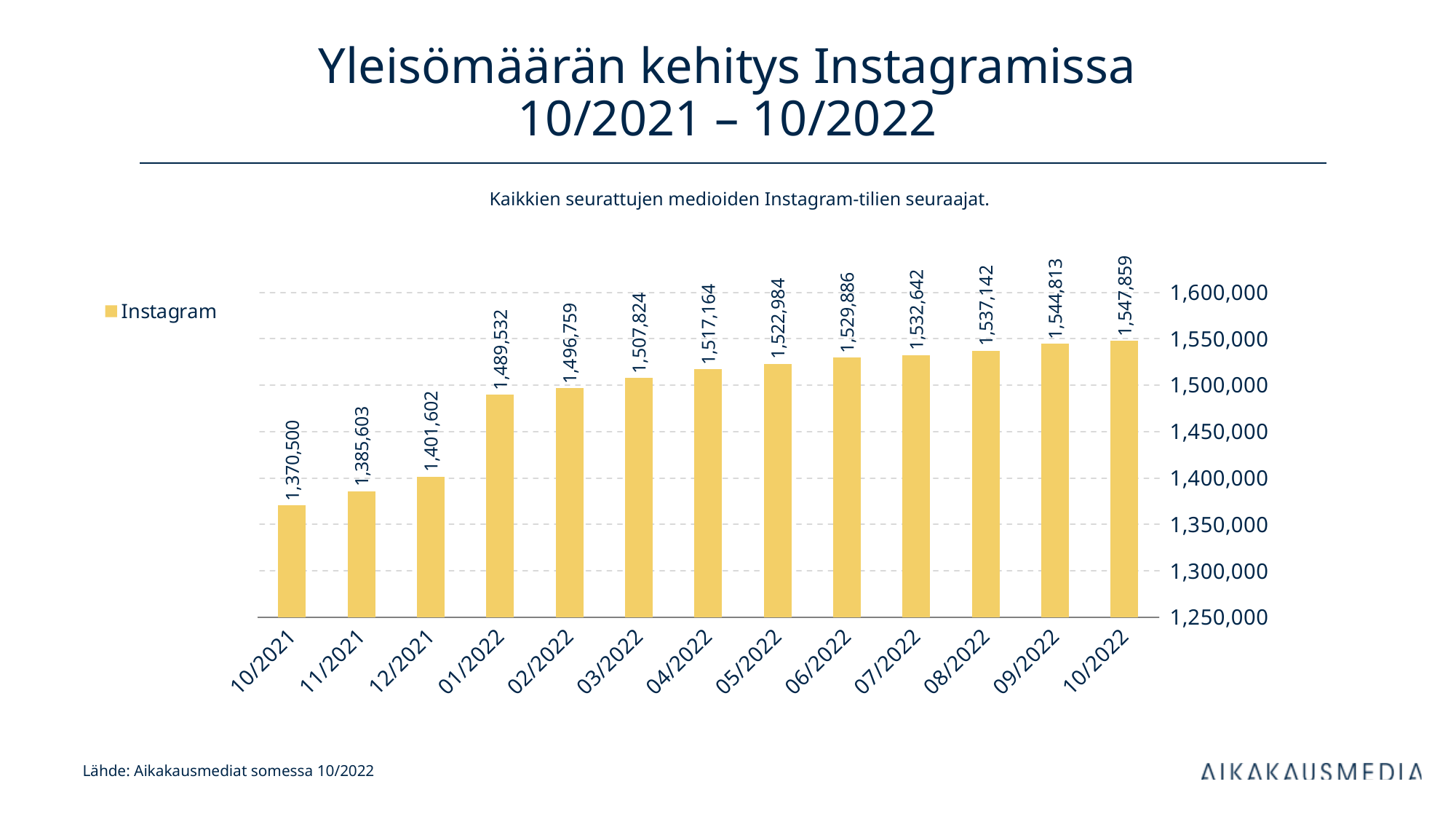
What is the value for 01/2022? 1,489,532 What is the difference between the values for 10/2022 and 10/2021? 177,359 Which is larger, the value for 12/2021 or the value for 03/2022? 03/2022 What is the value for 10/2021? 1,370,500 How many months are shown on the x axis? 13 Which month has the highest value? 10/2022 What is the value for 10/2022? 1,547,859 Is the value for 11/2021 greater or less than 1,400,000? less Which month has the lowest value? 10/2021 Do the values rise or fall from 10/2021 to 10/2022? rise What is the difference between the values for 01/2022 and 12/2021? 87,930 What kind of chart is shown on the slide? bar chart